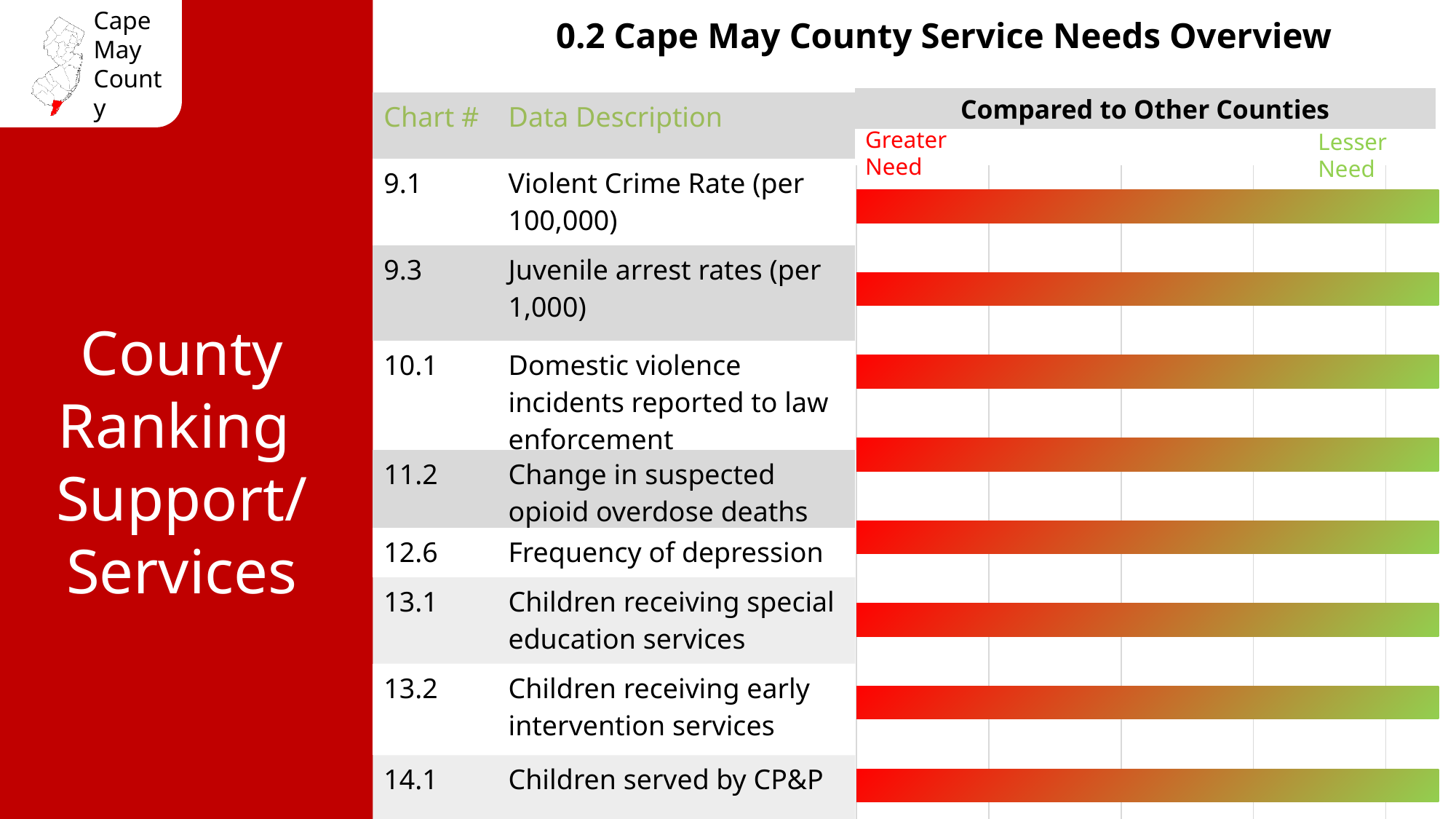
What is the title printed above the bar chart? Compared to Other Counties What kind of chart is shown under the heading "Compared to Other Counties"? Bar chart Which data description corresponds to chart number 12.6 in the table beside the bar chart? Frequency of depression What label appears at the left end of the bar chart's scale? Greater Need How many bars are plotted in the "Compared to Other Counties" chart? 8 Which chart number is listed for "Children served by CP&P"? 14.1